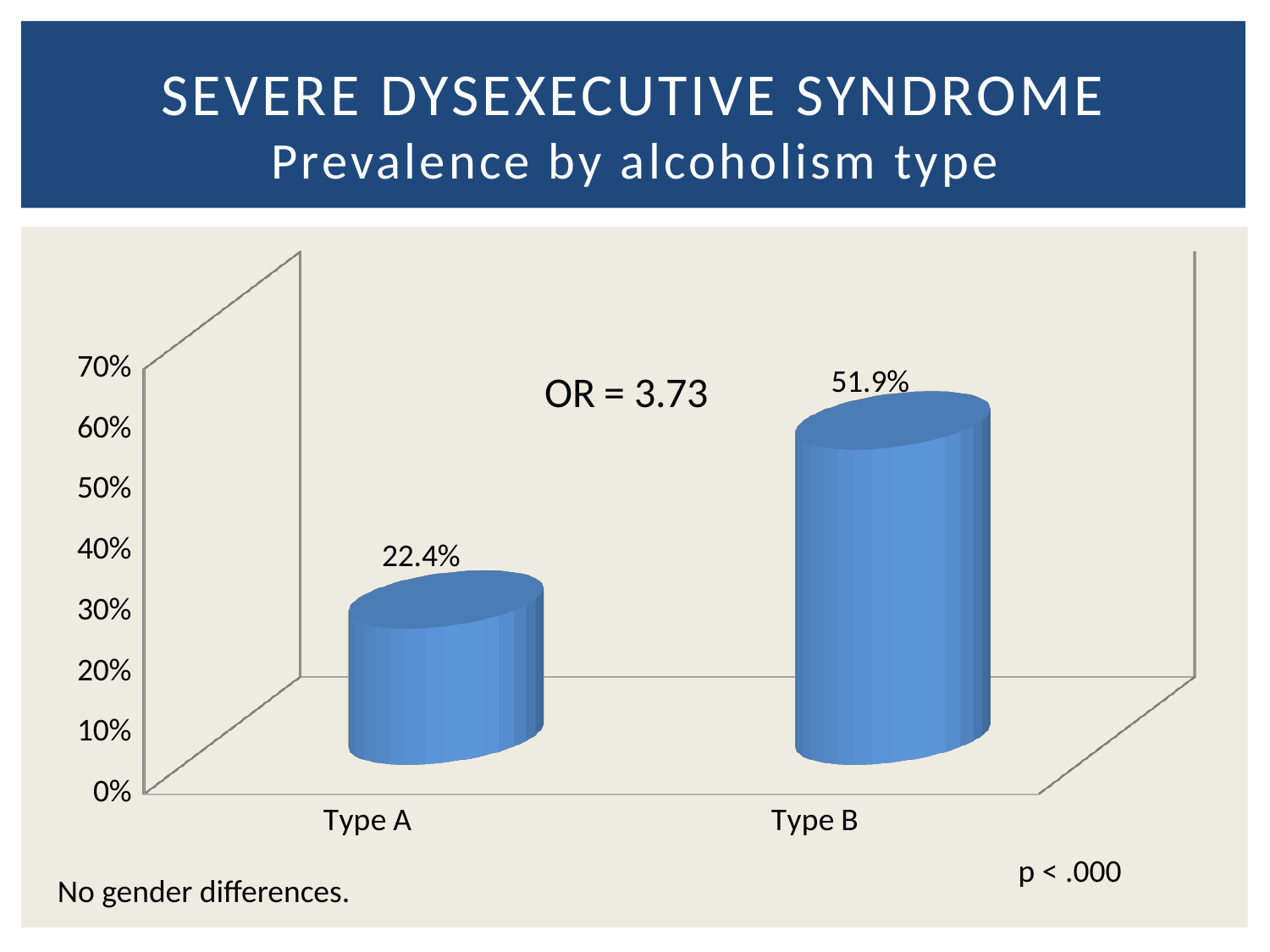
What is the difference in prevalence between Type B and Type A? 29.5% Is the prevalence for Type B greater or less than 50%? greater What is the maximum value shown on the vertical axis? 70% What is the prevalence of severe dysexecutive syndrome for Type B? 51.9% What kind of chart is shown on the slide? Bar chart What odds ratio (OR) is printed on the chart? OR = 3.73 Which alcoholism type has the lower prevalence of severe dysexecutive syndrome? Type A How many alcoholism types are shown on the chart? 2 Is the prevalence for Type A greater or less than 30%? less What is the prevalence of severe dysexecutive syndrome for Type A? 22.4% Which alcoholism type has the higher prevalence of severe dysexecutive syndrome? Type B